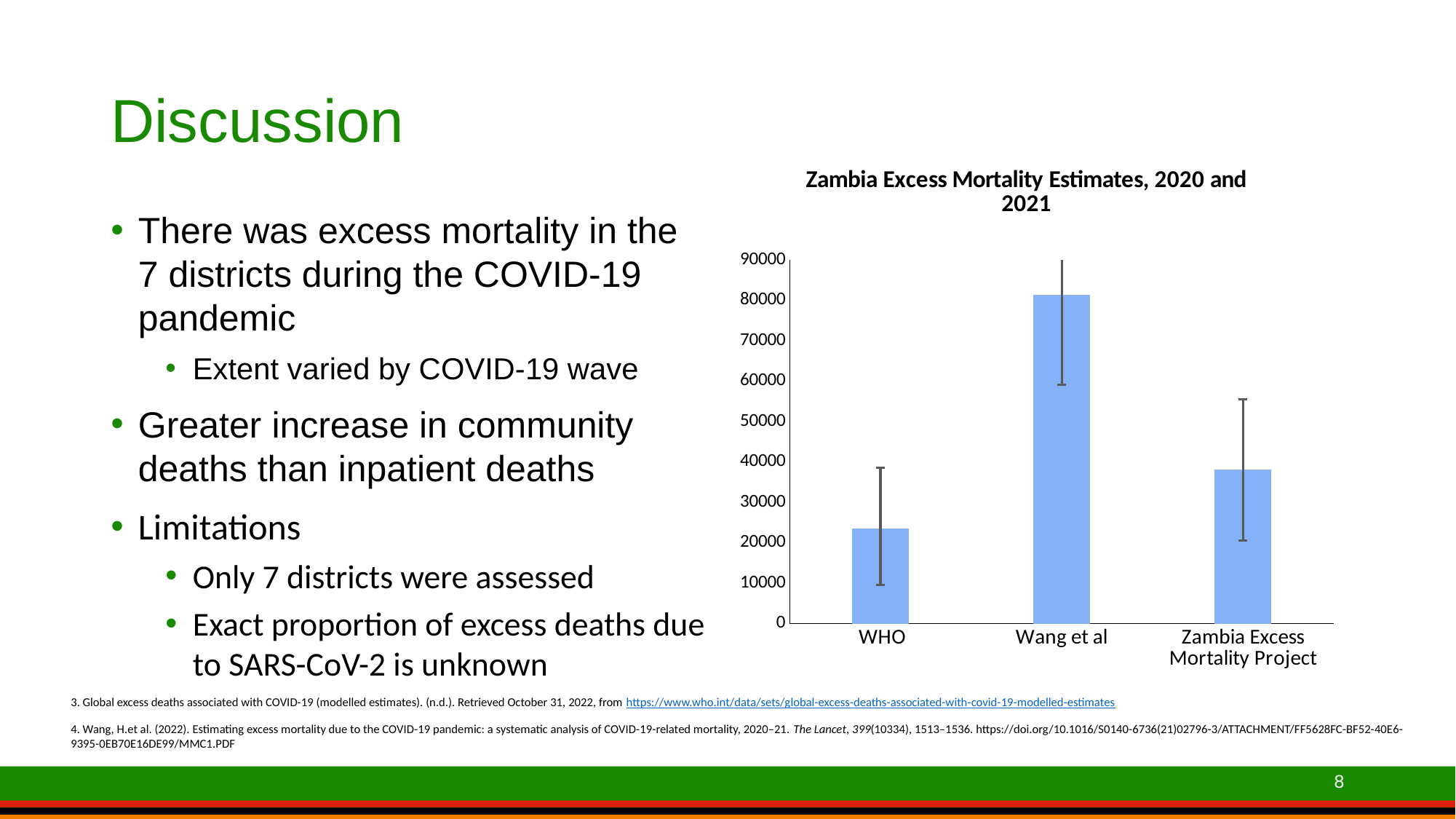
Is the value for Zambia Excess Mortality Project greater or less than 30000? greater What is the title of the chart? Zambia Excess Mortality Estimates, 2020 and 2021 Which is larger, the estimate for Wang et al or the estimate for Zambia Excess Mortality Project? Wang et al How many categories are plotted on the x axis of the chart? 3 What kind of chart is shown on the slide? bar chart Which is larger, the estimate for WHO or the estimate for Zambia Excess Mortality Project? Zambia Excess Mortality Project Do the bar values rise steadily from left to right across the x axis? No Is the value for WHO greater or less than 30000? less Which category has the highest excess mortality estimate? Wang et al What is the highest value shown on the vertical axis of the chart? 90000 Is the value for Wang et al greater or less than 70000? greater Which category has the lowest excess mortality estimate? WHO